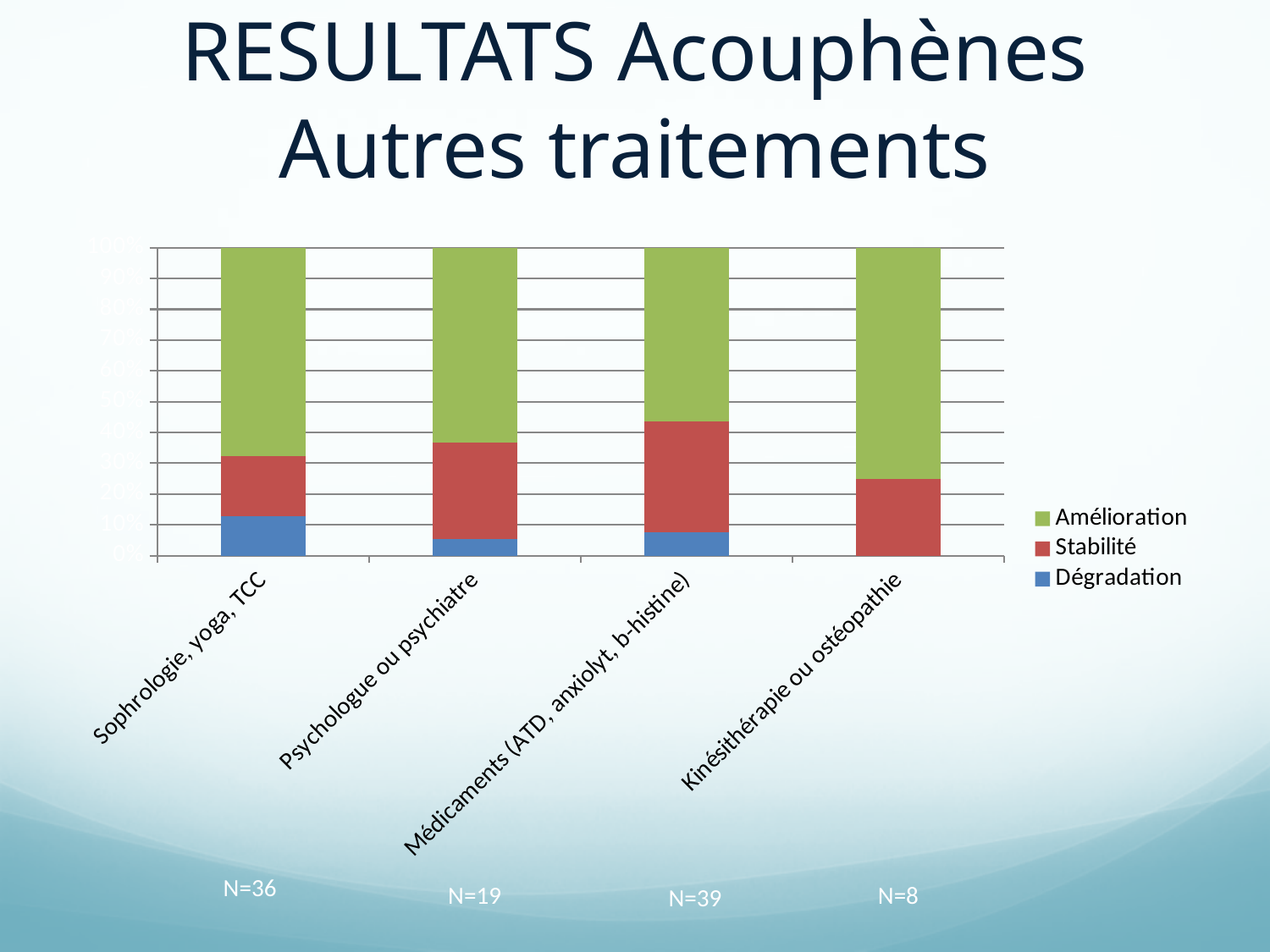
What kind of chart is shown on the slide? Stacked bar chart Which has the larger Stabilité share: Médicaments (ATD, anxiolyt, b-histine) or Sophrologie, yoga, TCC? Médicaments (ATD, anxiolyt, b-histine) Which category has the smallest Amélioration share? Médicaments (ATD, anxiolyt, b-histine) Which category has the largest Dégradation share? Sophrologie, yoga, TCC Is the Amélioration share for Médicaments (ATD, anxiolyt, b-histine) greater or less than 60%? less What sample size (N) is shown under the Médicaments (ATD, anxiolyt, b-histine) bar? N=39 Is the Amélioration share for Kinésithérapie ou ostéopathie greater or less than 70%? greater Is the Dégradation share for Sophrologie, yoga, TCC greater or less than 20%? less How many series does the legend list? 3 Which series is shown in green in the legend? Amélioration Which category has the largest Amélioration share? Kinésithérapie ou ostéopathie How many treatment categories are shown on the x axis? 4